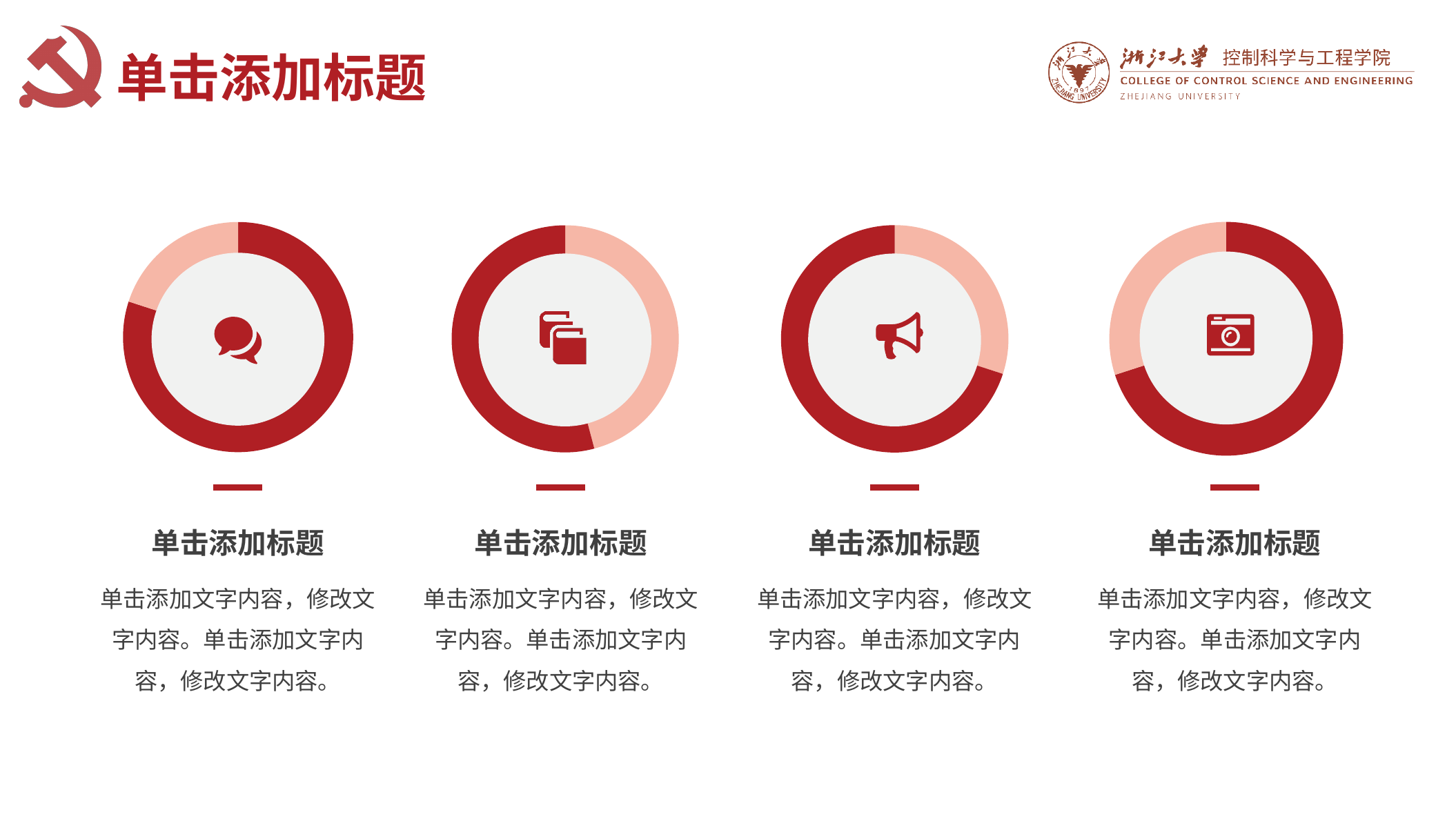
What kind of chart is the leftmost chart on the slide? Donut chart How many donut charts are shown on the slide? 4 Which of the four donut charts has the smallest light pink segment? The leftmost Which of the four donut charts has the largest light pink segment? The second from the left What icon appears in the centre of the third donut chart from the left? A megaphone In the second donut chart from the left, which segment is larger, the dark red one or the light pink one? Light pink In the third donut chart from the left, which segment is larger, the dark red one or the light pink one? Dark red In the leftmost donut chart, how many segments does the ring have? 2 In the rightmost donut chart, which segment is larger, the dark red one or the light pink one? Dark red What two colours are used for the segments of the donut charts? Dark red and light pink